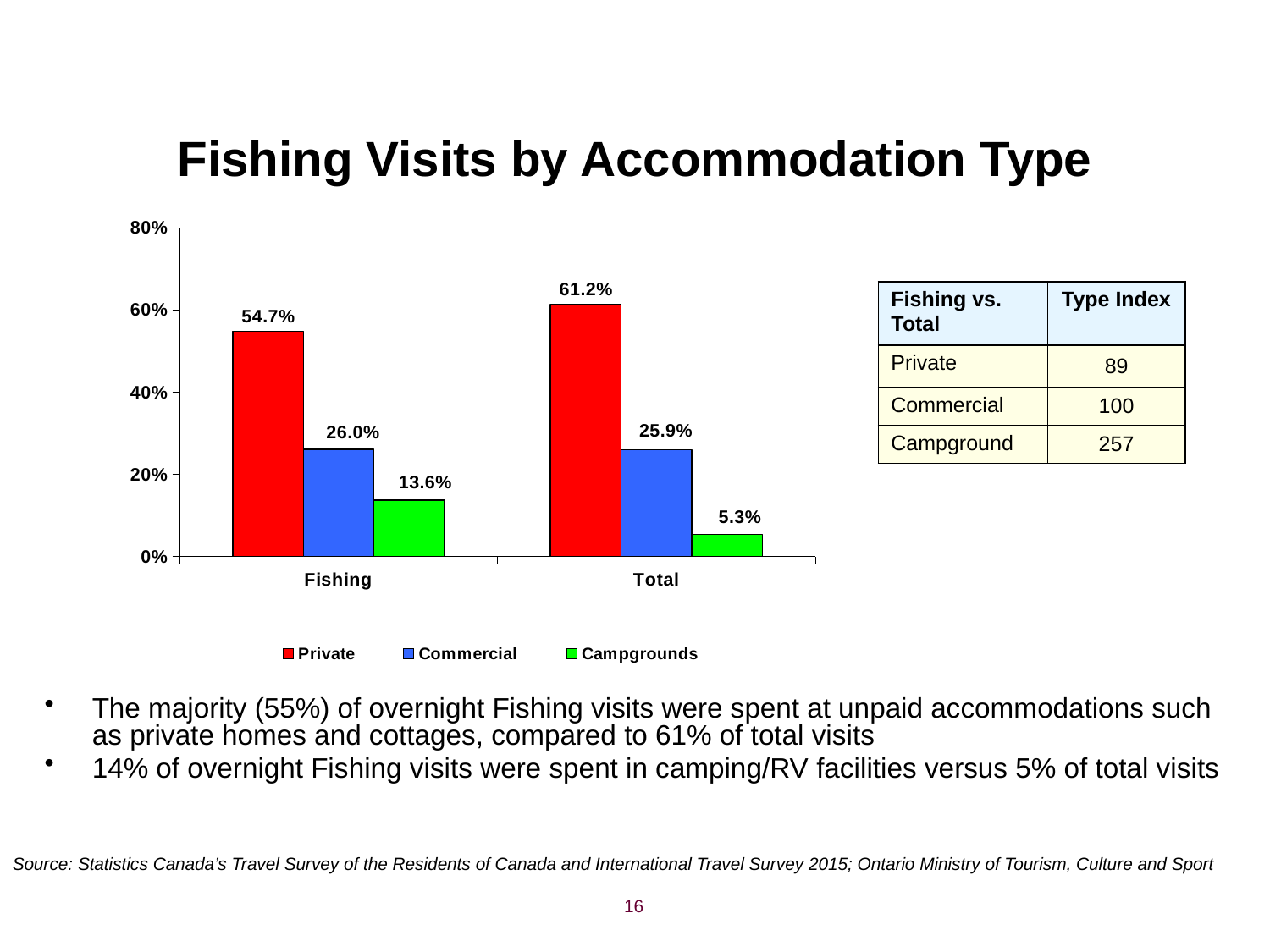
How many series does the legend list? 3 Which series has the lowest value in the Fishing category? Campgrounds What is the Private value for Fishing? 54.7% Is the Private value for Total greater or less than 60%? greater What is the difference between the Campgrounds values for Fishing and Total? 8.3% What is the difference between the Private values for Total and Fishing? 6.5% Which series has the highest value in the Total category? Private What kind of chart is shown on the slide? bar chart What is the Commercial value for Fishing? 26.0% What is the Campgrounds value for Total? 5.3% How many categories are shown on the x axis? 2 Which is larger, the Campgrounds value for Fishing or for Total? Fishing